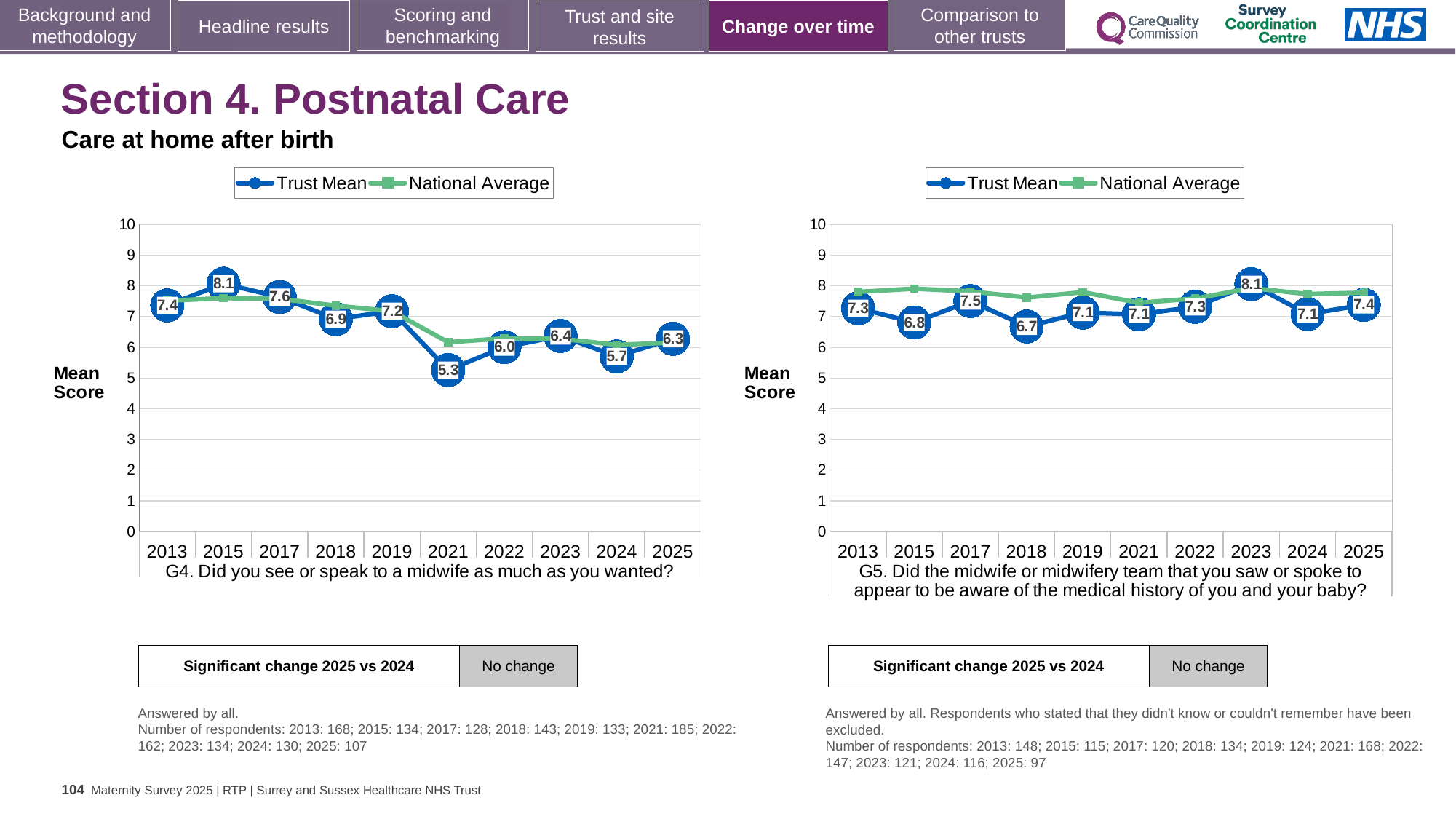
In the G4 chart (left), what is the Trust Mean for 2021? 5.3 How many years are plotted on the x axis of the G5 chart (right)? 10 In the G4 chart (left), what is the Trust Mean for 2015? 8.1 In the G4 chart (left), is the National Average for 2021 greater or less than 7? less What type of chart is the G4 chart (left)? Line chart In the G4 chart (left), which year has the lowest Trust Mean? 2021 In the G4 chart (left), which year has the highest Trust Mean? 2015 In the G5 chart (right), which year has the lowest Trust Mean? 2018 In the G5 chart (right), what is the Trust Mean for 2023? 8.1 In the G5 chart (right), is the Trust Mean higher in 2017 or 2018? 2017 In the G4 chart (left), what is the difference between the Trust Mean for 2025 and 2024? 0.6 In the G5 chart (right), is the National Average for 2013 greater or less than 7? greater